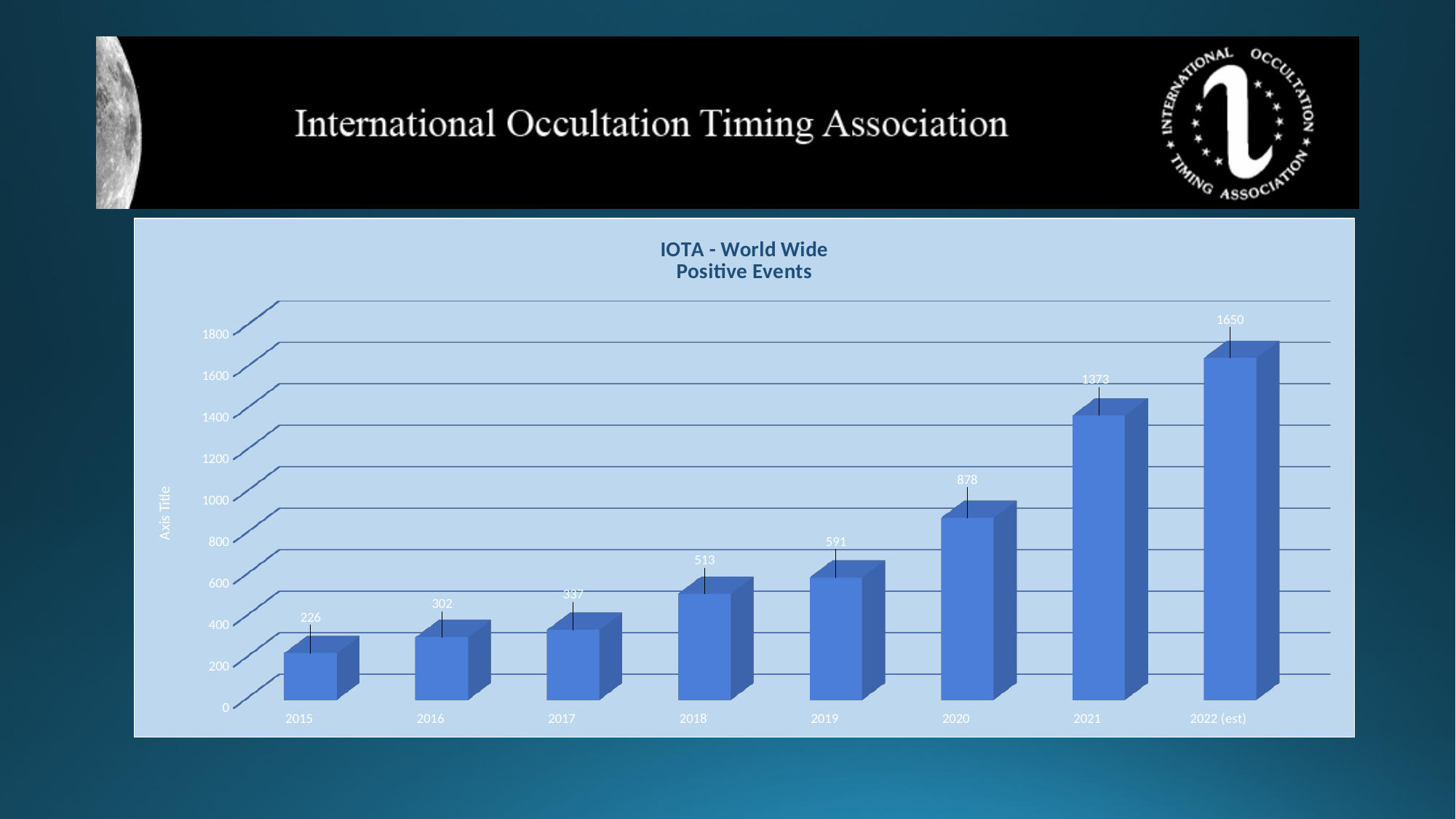
What is the value for 2022 (est)? 1650 What kind of chart is this? bar chart Which year has the highest value? 2022 (est) Which is larger, the value for 2018 or the value for 2019? 2019 What is the value for 2020? 878 How many years are shown on the x axis? 8 Is the value for 2021 greater or less than 1200? greater What is the value for 2015? 226 What is the difference between the values for 2021 and 2020? 495 Do the values rise or fall from 2015 to 2022 (est)? rise What is the title of the chart? IOTA - World Wide Positive Events Which year has the lowest value? 2015